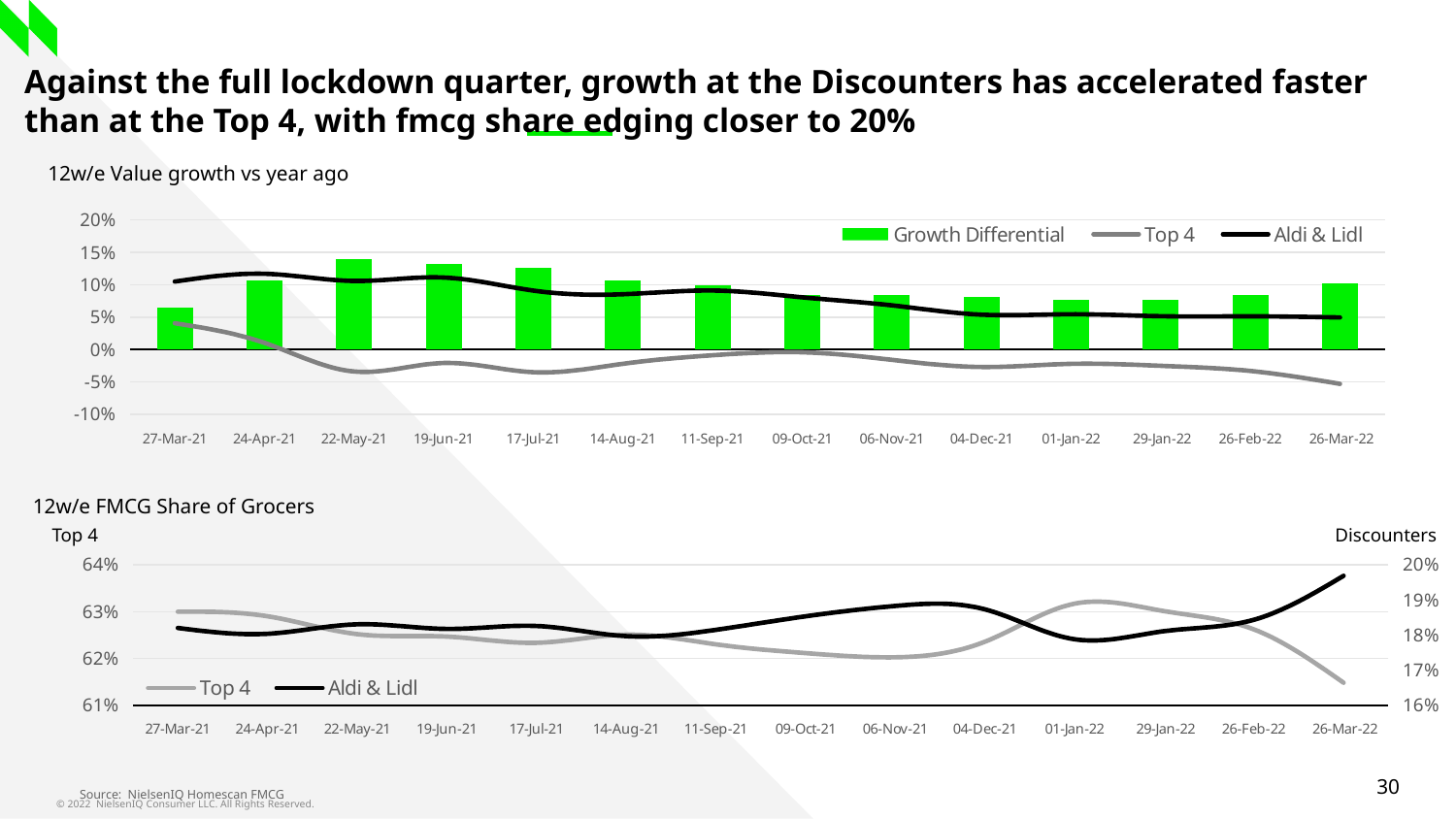
In the top chart, '12w/e Value growth vs year ago', is the Growth Differential value for 22-May-21 greater or less than 10%? greater In the top chart, '12w/e Value growth vs year ago', is the Top 4 value for 26-Mar-22 greater or less than 0%? less In the top chart, '12w/e Value growth vs year ago', at which date is the Growth Differential bar highest? 22-May-21 In the bottom chart, '12w/e FMCG Share of Grocers', is the Aldi & Lidl share at 26-Mar-22 greater or less than 19%? greater How many series does the legend of the top chart, '12w/e Value growth vs year ago', list? 3 How many series does the legend of the bottom chart, '12w/e FMCG Share of Grocers', list? 2 In the top chart, '12w/e Value growth vs year ago', which series is shown as bars? Growth Differential How many dates are shown on the x axis of the top chart, '12w/e Value growth vs year ago'? 14 In the top chart, '12w/e Value growth vs year ago', which is larger at 26-Mar-22: the Aldi & Lidl value or the Top 4 value? Aldi & Lidl In the bottom chart, '12w/e FMCG Share of Grocers', does the Top 4 share rise or fall between 26-Feb-22 and 26-Mar-22? fall In the bottom chart, '12w/e FMCG Share of Grocers', what label is given to the right-hand axis? Discounters In the top chart, '12w/e Value growth vs year ago', at which date is the Growth Differential bar lowest? 27-Mar-21